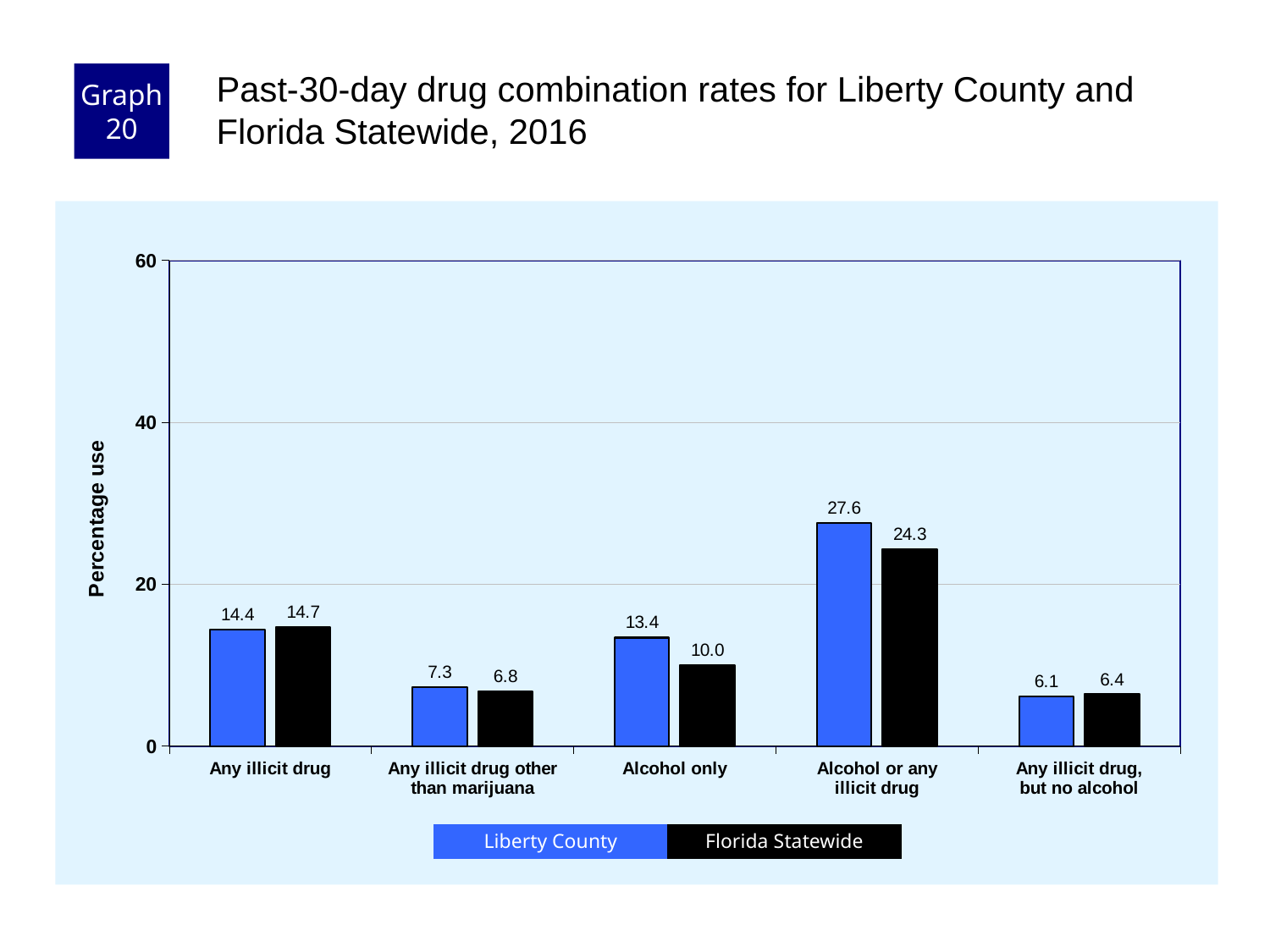
Which category has the lowest Florida Statewide value? Any illicit drug, but no alcohol How many series does the legend list? 2 Is the Liberty County value for Alcohol or any illicit drug greater or less than 20? greater What is the Liberty County value for Alcohol only? 13.4 For Any illicit drug other than marijuana, which is larger: Liberty County or Florida Statewide? Liberty County What is the difference between the Liberty County and Florida Statewide values for Alcohol only? 3.4 Which category has the highest Liberty County value? Alcohol or any illicit drug What is the label of the y axis? Percentage use How many categories are shown on the x axis? 5 What is the Florida Statewide value for Alcohol or any illicit drug? 24.3 What is the Liberty County value for Any illicit drug, but no alcohol? 6.1 What kind of chart is shown on the slide? bar chart